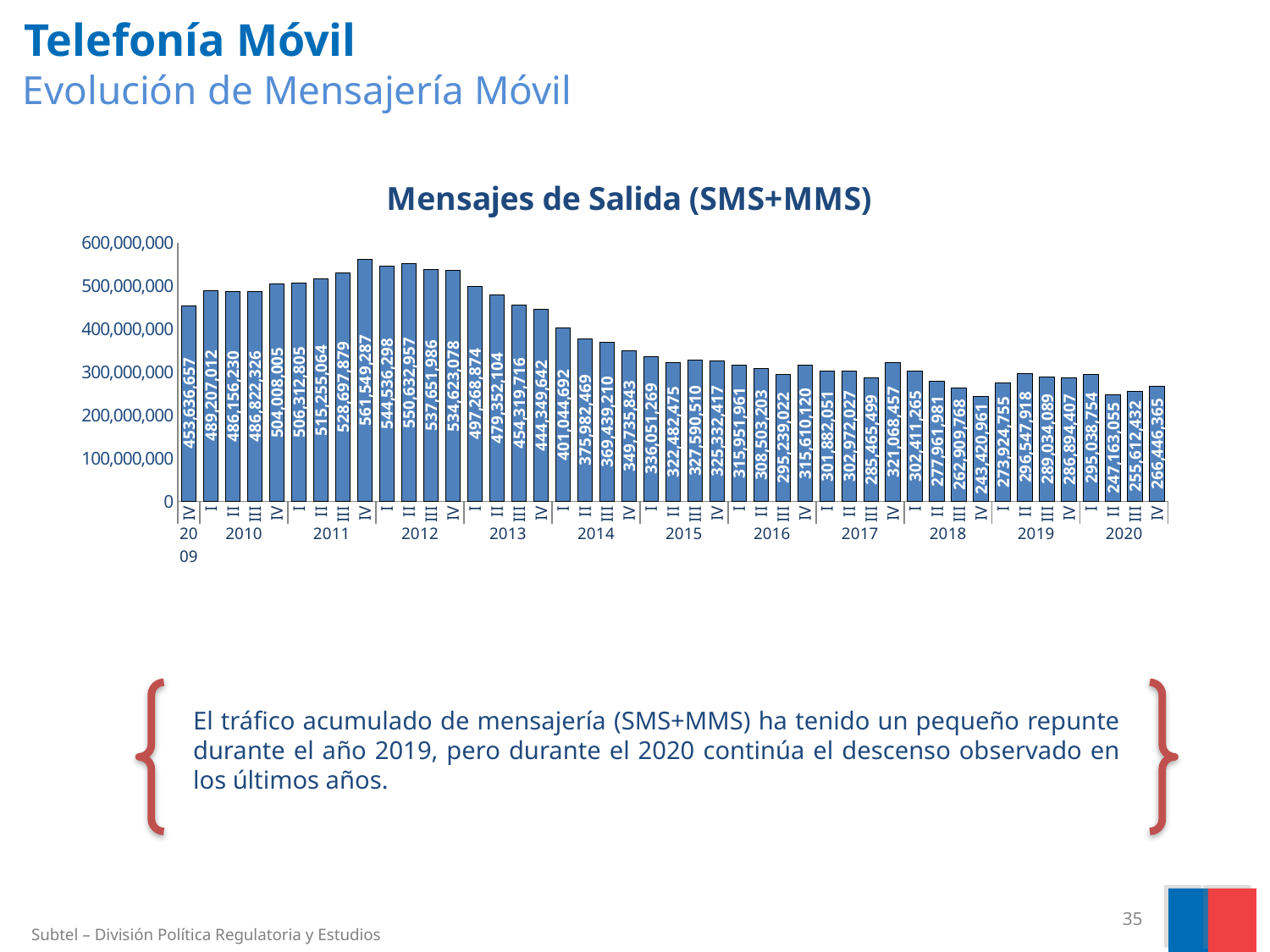
What is the value for quarter IV of 2020? 266,446,365 What is the difference between the values for quarter I of 2020 and quarter II of 2020? 47,875,699 What is the value for quarter IV of 2009? 453,636,657 What type of chart is shown on the slide? Bar chart Do the values generally rise or fall from 2012 to 2018? Fall Is the value for quarter I of 2014 greater or less than 400,000,000? greater What is the title of the chart? Mensajes de Salida (SMS+MMS) What is the value for quarter IV of 2011? 561,549,287 Which is larger, the value for quarter I of 2019 or quarter II of 2019? II 2019 Which quarter has the highest value? IV 2011 How many bars are plotted in the chart? 45 Which quarter has the lowest value? IV 2018